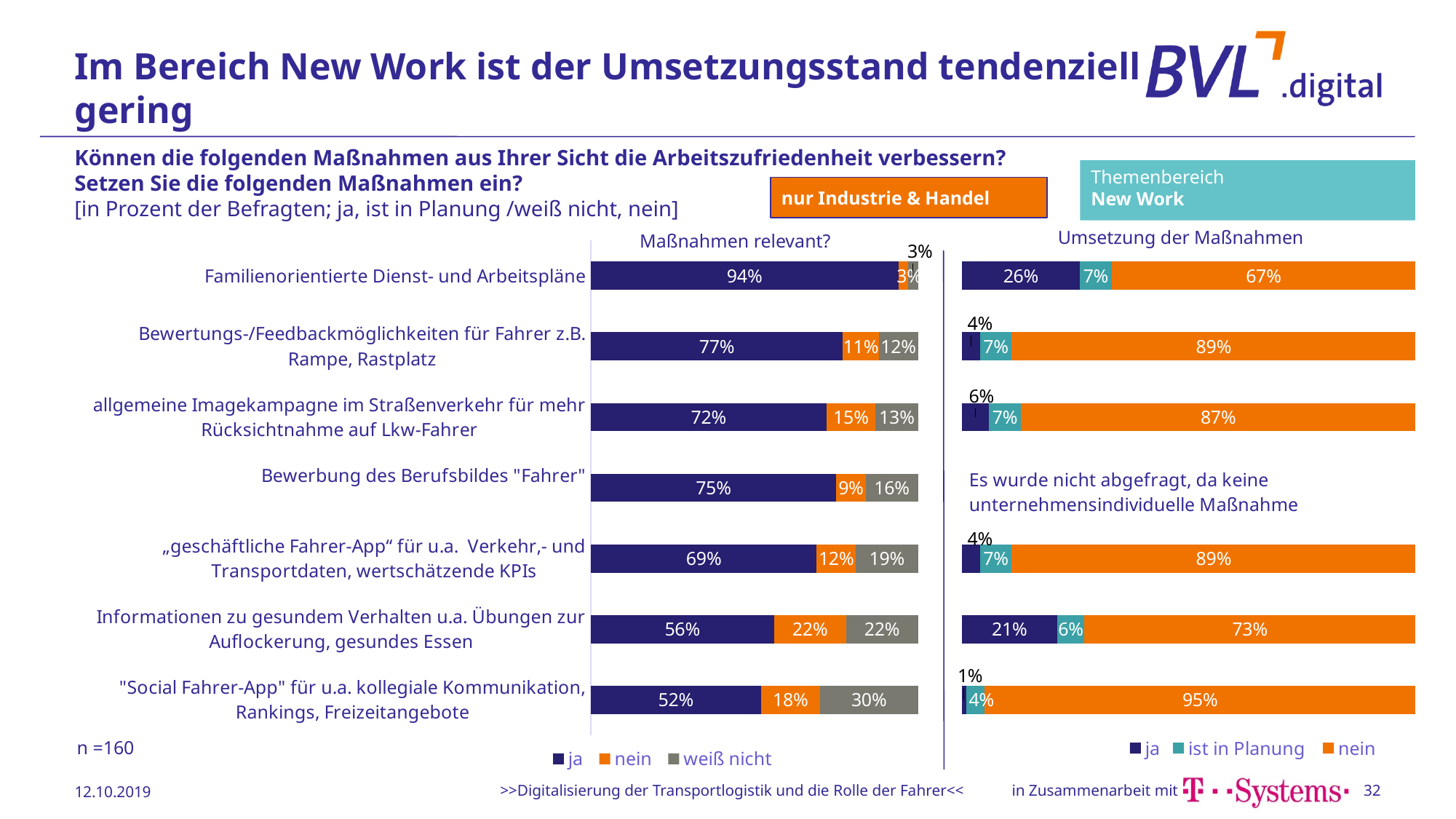
In the "Umsetzung der Maßnahmen" chart, what is the total of the stacked bar for "Familienorientierte Dienst- und Arbeitspläne"? 100% In the "Maßnahmen relevant?" chart, what is the difference between the "ja" values for "Bewertungs-/Feedbackmöglichkeiten für Fahrer" and "allgemeine Imagekampagne im Straßenverkehr"? 5% In the "Umsetzung der Maßnahmen" chart, which category has the highest "ja" value? Familienorientierte Dienst- und Arbeitspläne In the "Umsetzung der Maßnahmen" chart, what is the "nein" value for "Social Fahrer-App"? 95% In the "Maßnahmen relevant?" chart, which category has the lowest "ja" value? "Social Fahrer-App" für u.a. kollegiale Kommunikation, Rankings, Freizeitangebote In the "Maßnahmen relevant?" chart, what is the "ja" value for "Familienorientierte Dienst- und Arbeitspläne"? 94% In the "Maßnahmen relevant?" chart, how many series does the legend list? 3 In the "Maßnahmen relevant?" chart, how many categories are plotted? 7 What kind of chart is the "Umsetzung der Maßnahmen" chart? Stacked bar chart In the "Maßnahmen relevant?" chart, what is the "weiß nicht" value for "Social Fahrer-App"? 30% In the "Umsetzung der Maßnahmen" chart, is the "nein" value larger for "Familienorientierte Dienst- und Arbeitspläne" or for "Informationen zu gesundem Verhalten"? Informationen zu gesundem Verhalten In the "Umsetzung der Maßnahmen" chart, what is the "ist in Planung" value for "Informationen zu gesundem Verhalten"? 6%